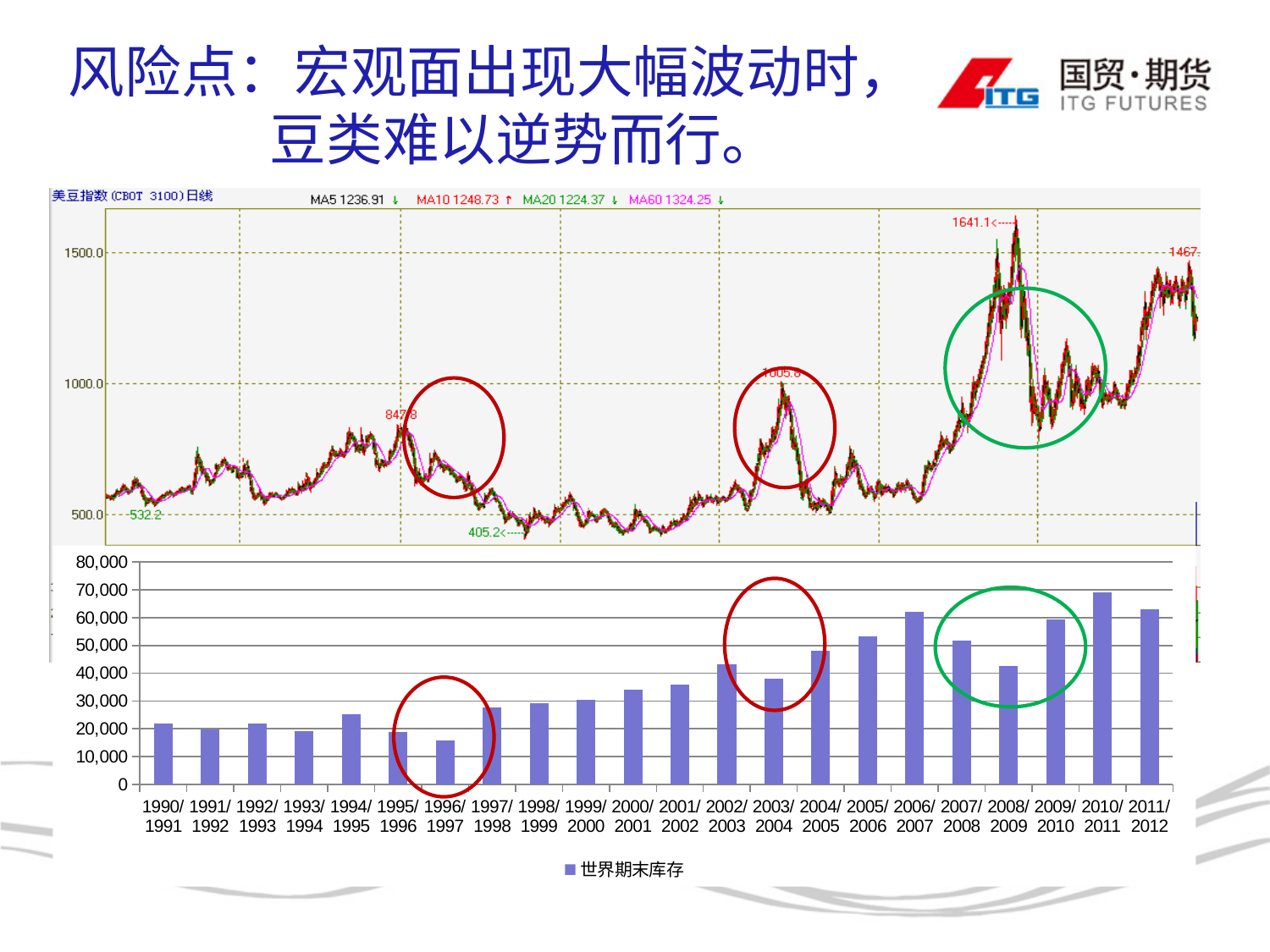
In the bottom bar chart, is the value for 2008/2009 greater or less than 50,000? less In the top line chart, what is the peak value labelled near 2008? 1641.1 In the bottom bar chart, is the value for 1996/1997 greater or less than 20,000? less In the bottom bar chart, which is larger, the value for 2002/2003 or the value for 2003/2004? 2002/2003 In the bottom bar chart, which marketing year has the highest value? 2010/2011 In the bottom bar chart, which marketing year has the lowest value? 1996/1997 In the bottom bar chart, is the value for 2006/2007 greater or less than 60,000? greater What kind of chart is the bottom chart on the slide? bar chart How many series does the legend of the bottom bar chart list? 1 In the bottom bar chart, how many categories (marketing years) are shown on the x axis? 22 In the bottom bar chart, do the values generally rise or fall from 1996/1997 to 2006/2007? rise In the top line chart, what MA5 value is shown in the header? 1236.91